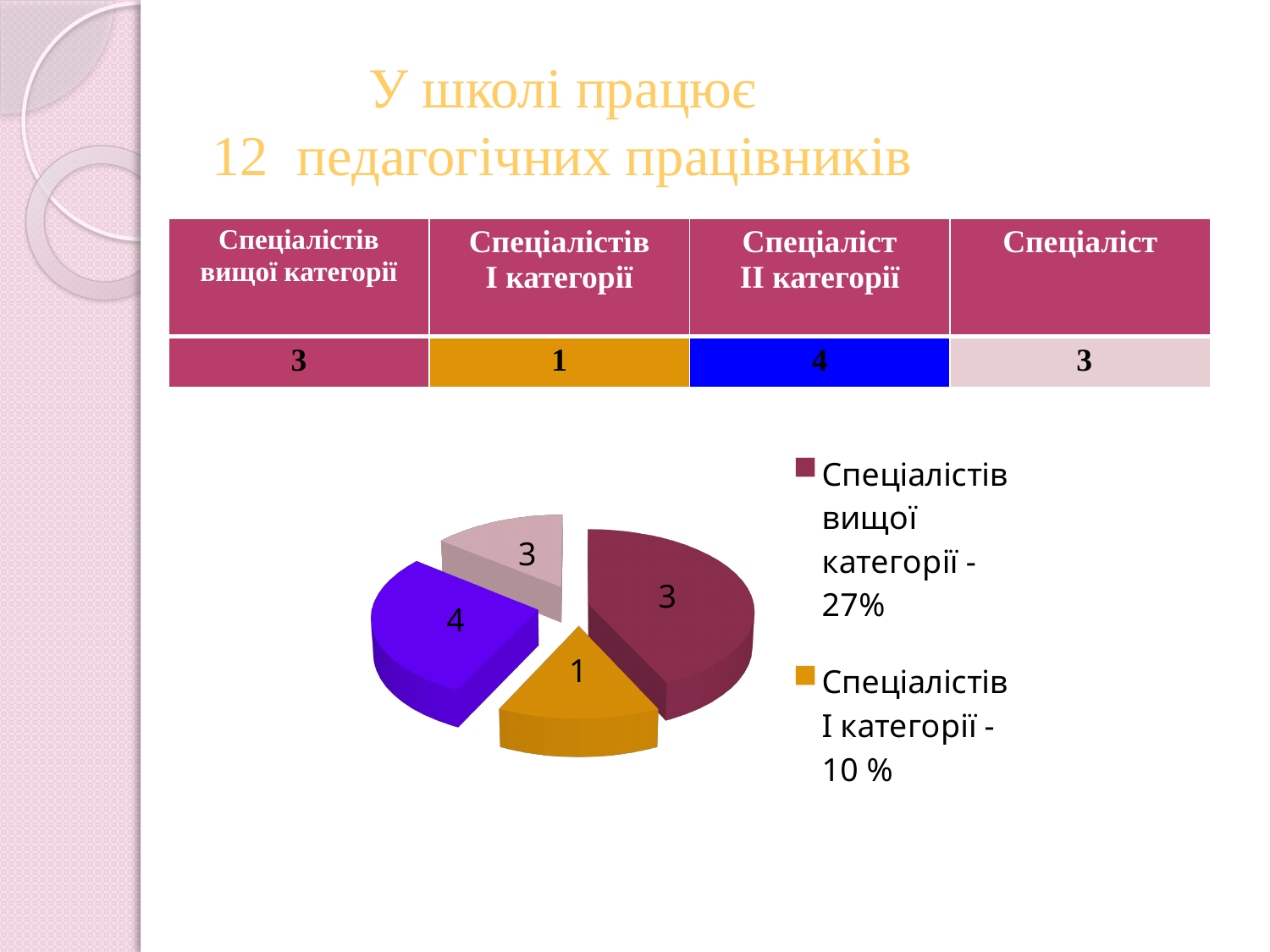
How many entries does the pie chart's legend list? 2 What value is shown on the blue slice of the pie chart? 4 How many slices does the pie chart have? 4 What kind of chart is shown on the slide? pie chart What is the difference between the blue slice and the orange slice? 3 What value is shown on the orange slice (Спеціалістів I категорії)? 1 What is the total of all slice values in the pie chart? 11 What is the value of the smallest slice in the pie chart? 1 What share of the pie does the legend give for Спеціалістів вищої категорії? 27% What value is shown on the dark magenta slice (Спеціалістів вищої категорії)? 3 Which is larger, the blue slice or the orange slice? the blue slice